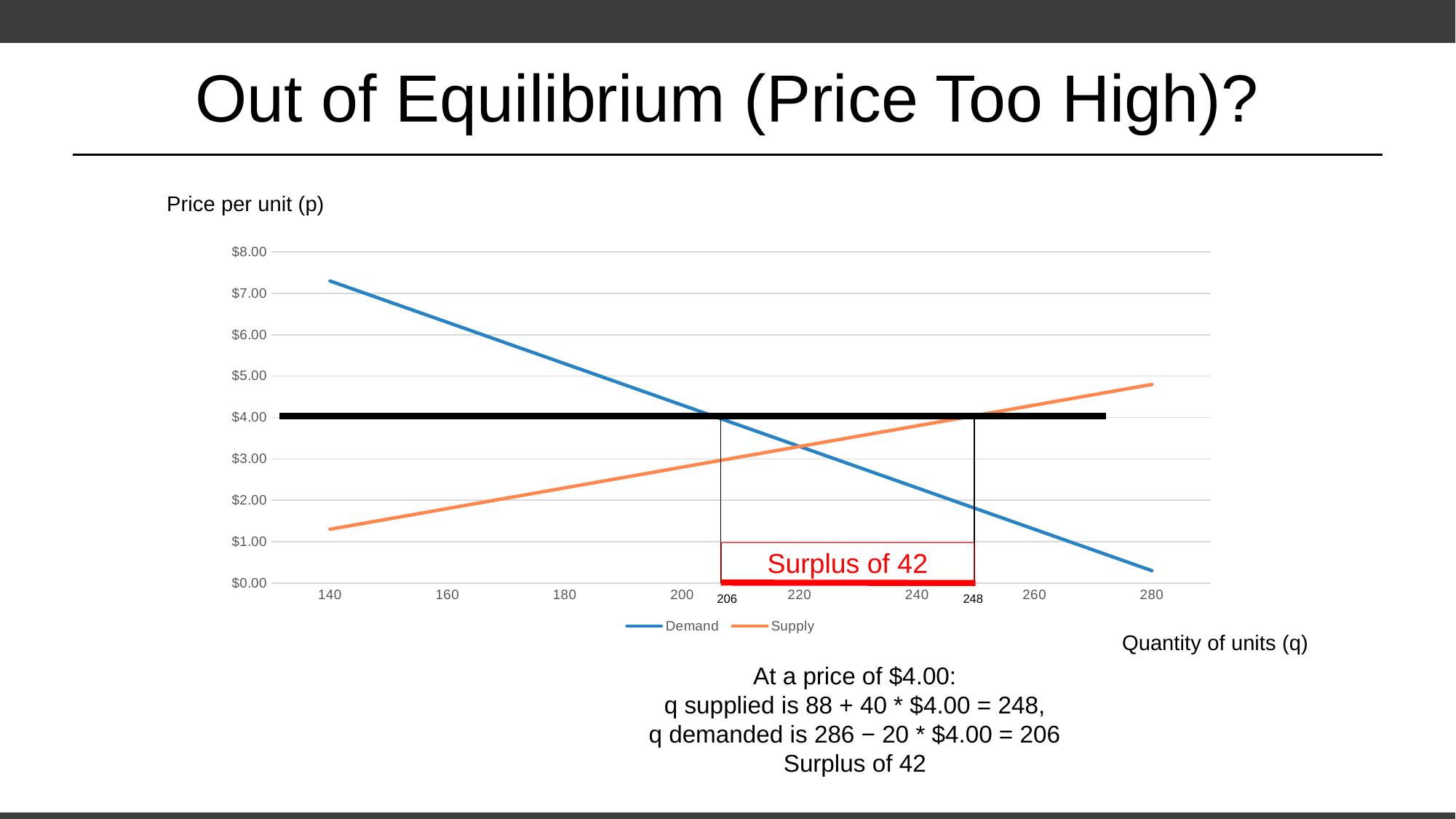
What is the difference between quantity supplied and quantity demanded at a price of $4.00? 42 What are the two series named in the chart's legend? Demand and Supply At a price of $4.00, what is the quantity demanded shown on the chart? 206 At a price of $4.00, what is the quantity supplied shown on the chart? 248 What kind of chart is shown on the slide? line chart What is the label on the chart's horizontal axis? Quantity of units (q) How many series does the chart's legend list? 2 Does the Demand line rise or fall as quantity increases along the x axis? fall Is the Demand price at a quantity of 280 greater or less than $1.00? less Does the Supply line rise or fall as quantity increases along the x axis? rise Is the Demand price at a quantity of 140 greater or less than $7.00? greater At a quantity of 140, which line shows the higher price, Demand or Supply? Demand